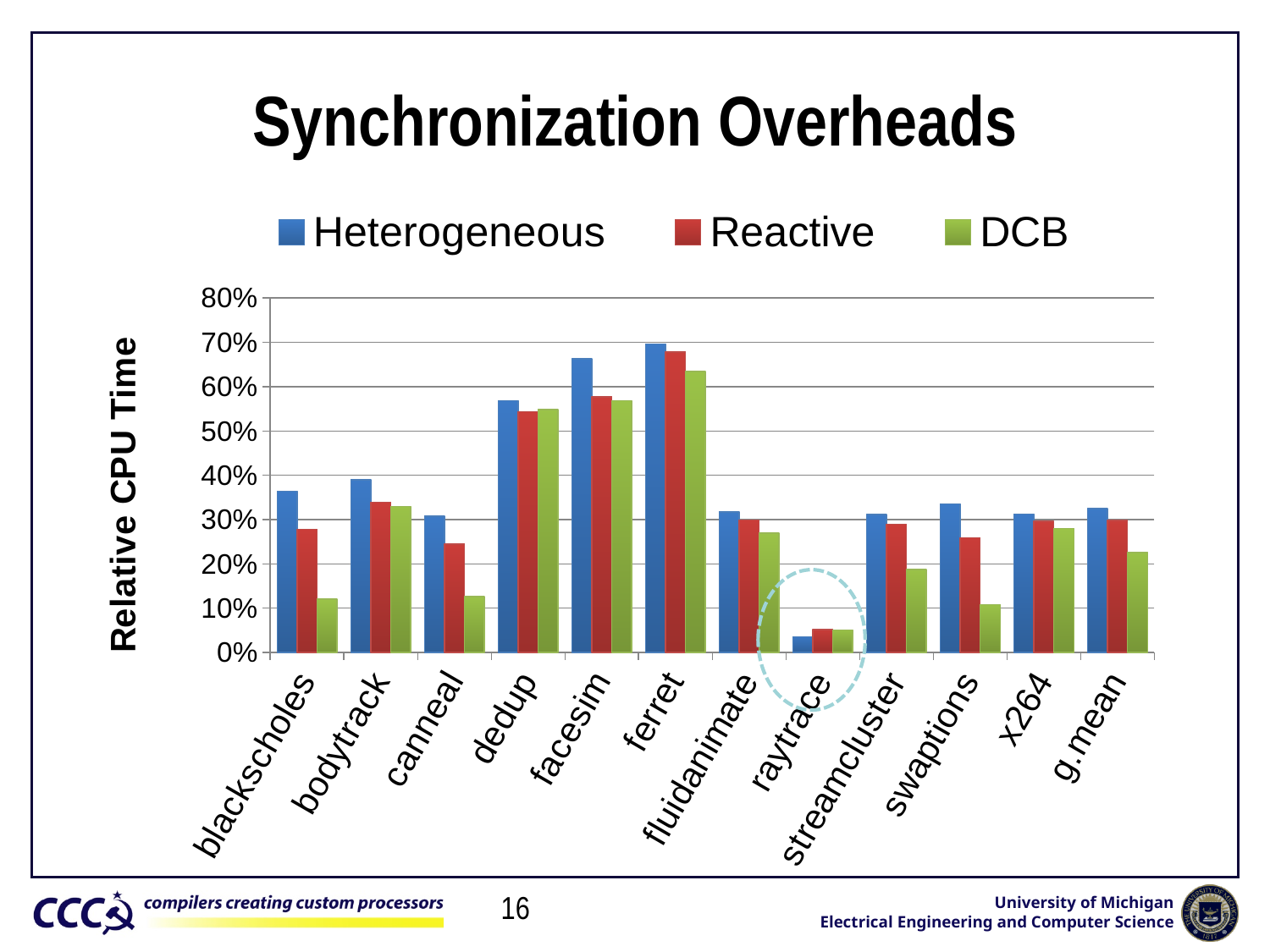
What kind of chart is shown on the slide? bar chart Which category has the lowest Heterogeneous value? raytrace Is the Heterogeneous value for dedup greater or less than 50%? greater For canneal, which is larger: the Reactive value or the DCB value? Reactive Which category has the highest DCB value? ferret What is the label of the y axis? Relative CPU Time For blackscholes, which is larger: the Heterogeneous value or the DCB value? Heterogeneous Which category has the highest Heterogeneous value? ferret Is the Reactive value for ferret greater or less than 60%? greater Is the Reactive value for swaptions greater or less than 30%? less How many categories are shown on the x axis? 12 How many series does the legend list? 3